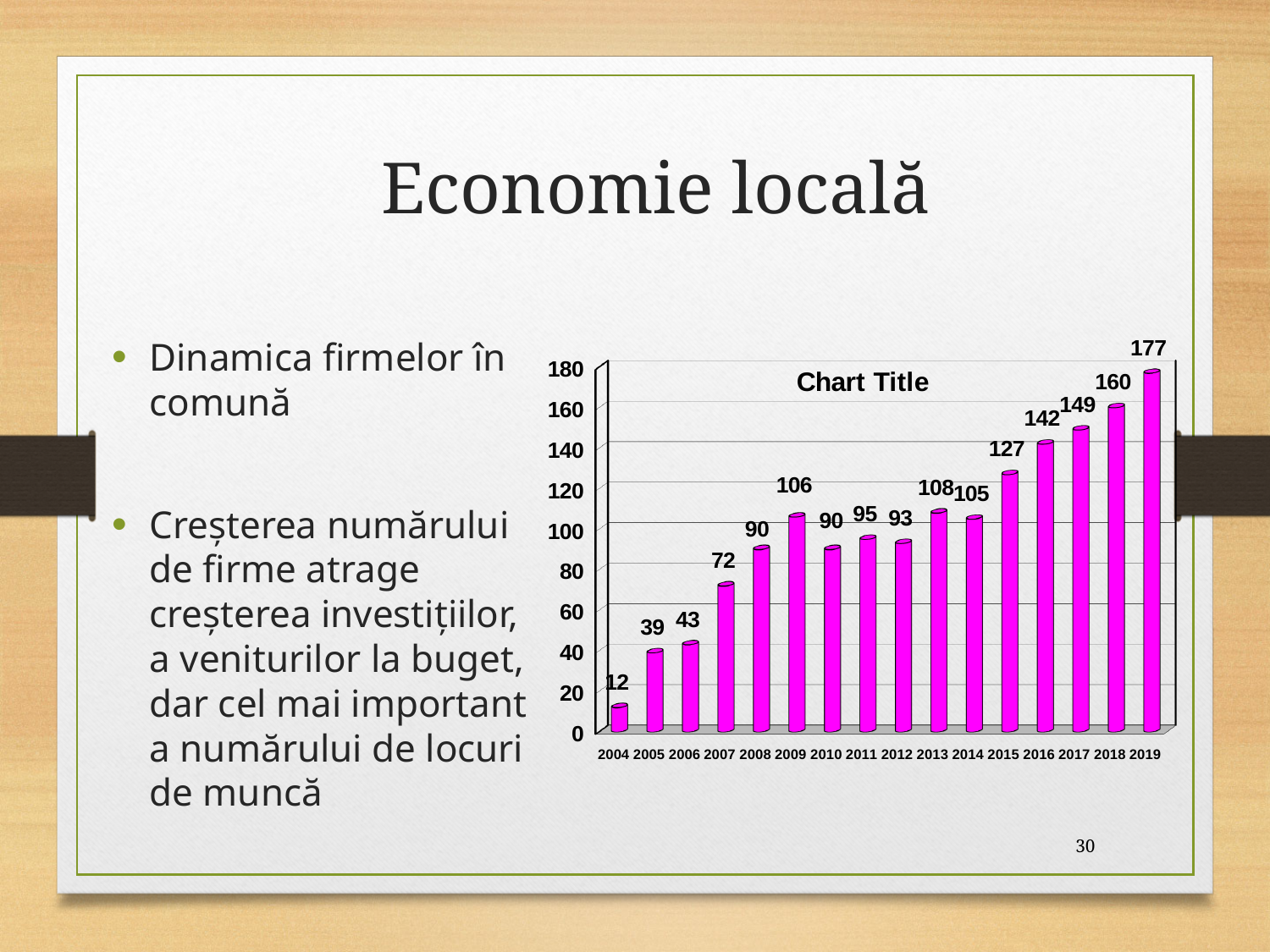
What is the difference between the values for 2009 and 2007? 34 What is the title shown on the chart? Chart Title What is the value for 2019? 177 Which year has the highest value? 2019 What is the value for 2013? 108 What is the value for 2004? 12 Which is larger, the value for 2011 or the value for 2012? 2011 Which year has the lowest value? 2004 What kind of chart is shown on the slide? bar chart How many years are shown on the x axis? 16 Do the values generally rise or fall from 2004 to 2019? rise What is the difference between the values for 2019 and 2018? 17